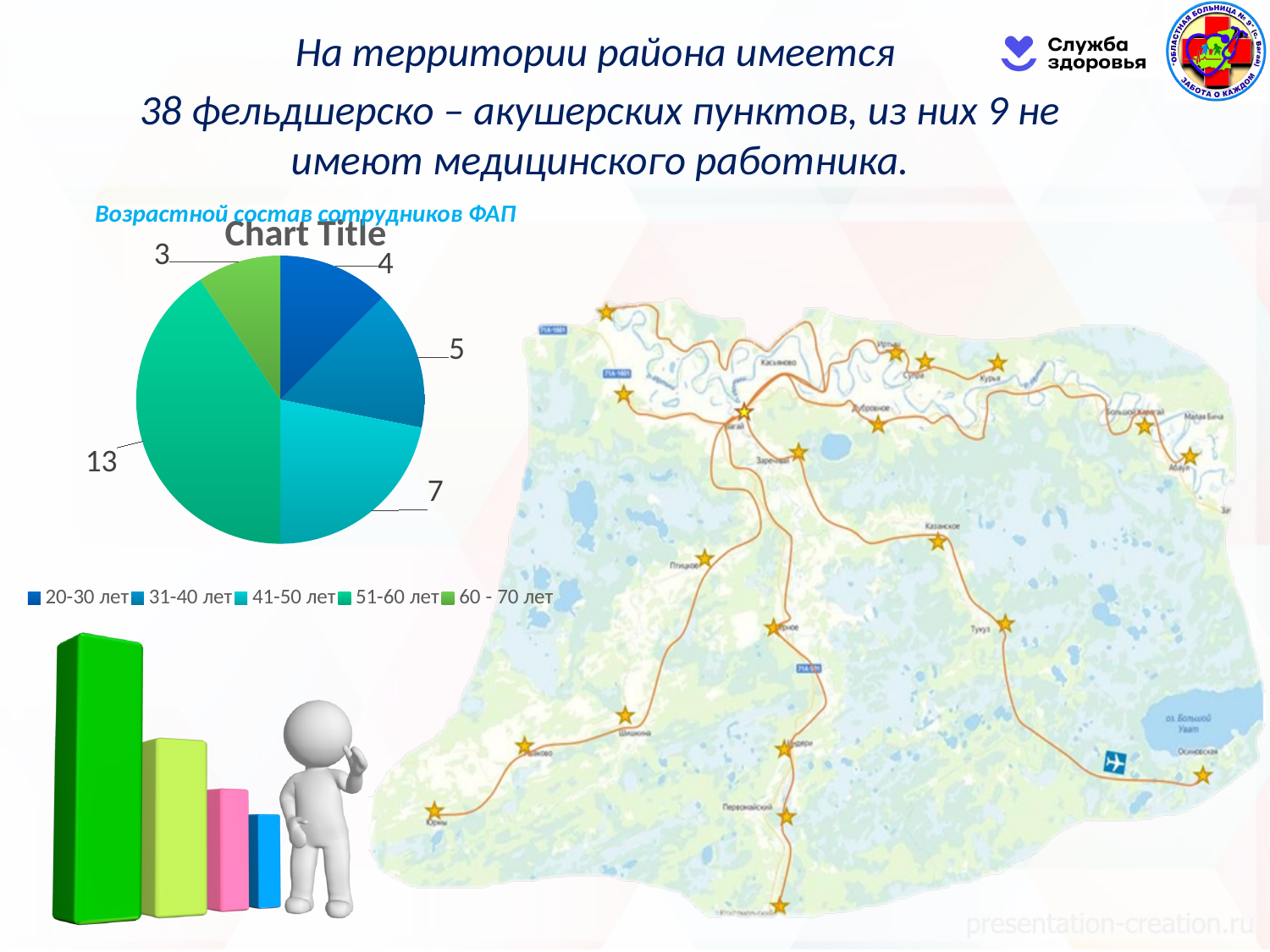
Which age group has the smallest slice in the pie chart? 60 - 70 лет In the pie chart, which is larger: the value for 31-40 лет or the value for 41-50 лет? 41-50 лет In the pie chart, what is the value for the 51-60 лет category? 13 In the pie chart, what is the value for the 20-30 лет category? 4 What is the total of all the values shown in the pie chart? 32 What type of chart is used to show the age composition of FAP staff (Возрастной состав сотрудников ФАП)? pie chart In the pie chart, what is the value for the 60 - 70 лет category? 3 In the pie chart, what is the value for the 41-50 лет category? 7 What share of the pie chart does the 20-30 лет slice represent? 12.5% In the pie chart, what is the difference between the values for 51-60 лет and 41-50 лет? 6 How many categories does the pie chart legend list? 5 Which age group has the largest slice in the pie chart? 51-60 лет